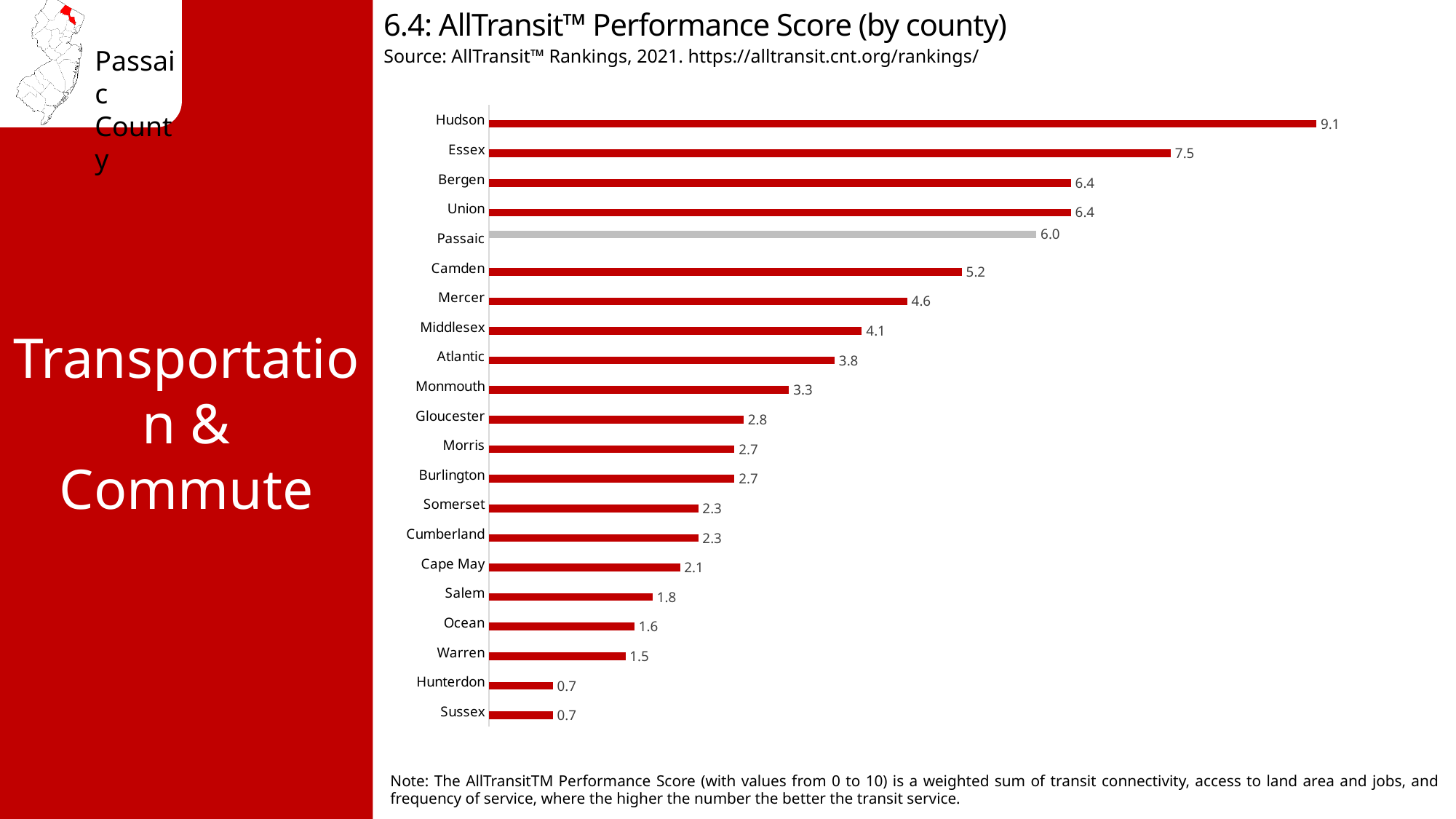
What is the AllTransit Performance Score for Warren county? 1.5 Which county has the highest AllTransit Performance Score? Hudson What is the AllTransit Performance Score for Mercer county? 4.6 What is the difference between the scores of Passaic and Camden? 0.8 What kind of chart is shown on the slide? Bar chart Which two counties share the lowest score of 0.7? Hunterdon and Sussex What is the AllTransit Performance Score for Passaic county? 6.0 Which county's bar is shown in grey rather than red? Passaic How many counties are shown in the chart? 21 What is the difference between the scores of Hudson and Essex? 1.6 Which county has a higher score, Camden or Middlesex? Camden What is the title of the chart? 6.4: AllTransit™ Performance Score (by county)